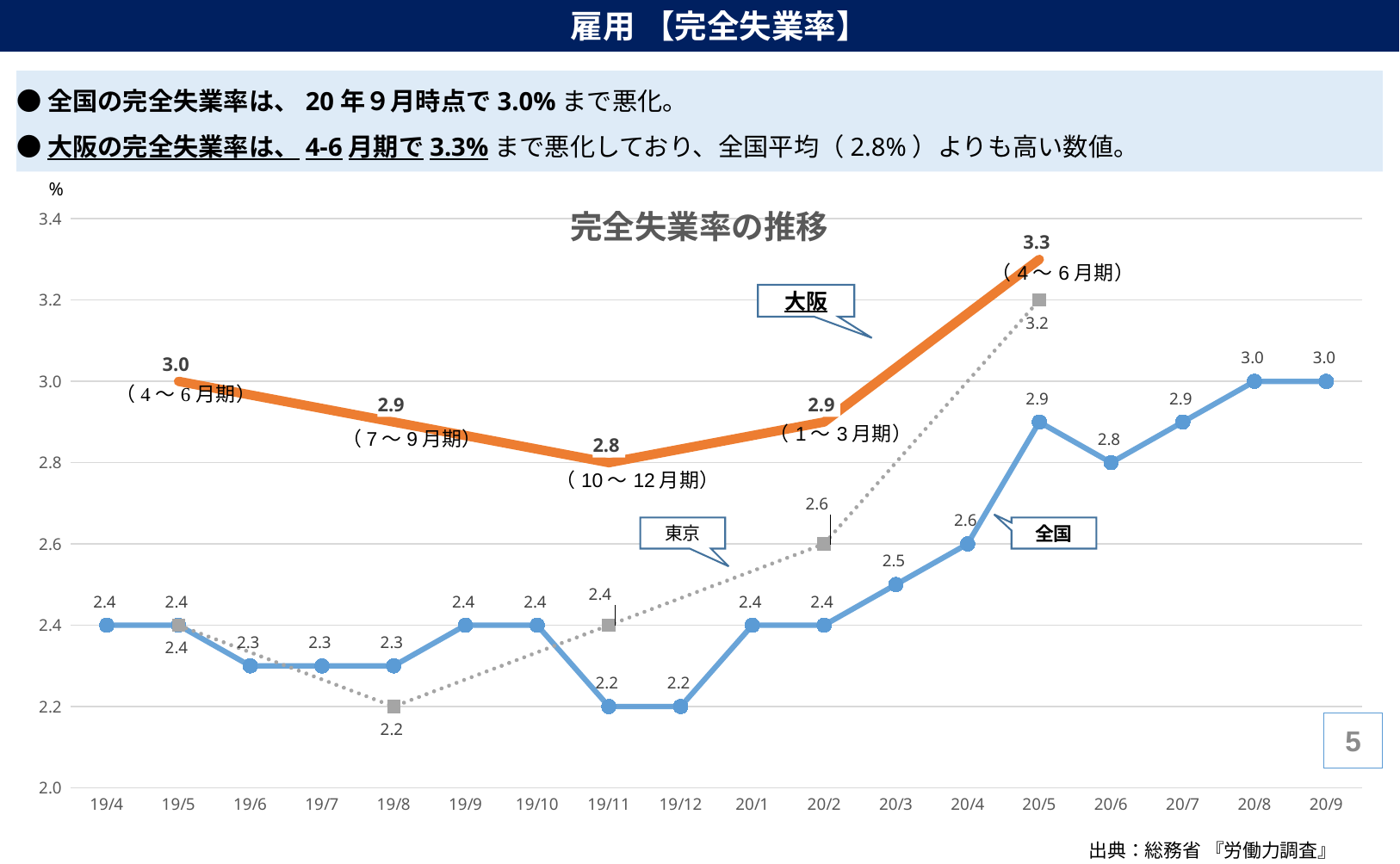
How many months are shown on the x axis? 18 What is the difference between the 東京 values at 20/5 and 20/2? 0.6 What kind of chart is shown on the slide? line chart What is the chart's title? 完全失業率の推移 What is the value of the 全国 series at 20/6? 2.8 What is the highest value shown for the 大阪 series? 3.3 Does the 全国 series rise or fall from 20/2 to 20/5? rise What is the value of the 大阪 series for the 10～12月期 period? 2.8 What is the value of the 東京 series at 20/5? 3.2 What is the value of the 全国 series at 20/9? 3.0 At 20/5, which series has the higher value, 東京 or 全国? 東京 What is the lowest value shown for the 全国 series? 2.2